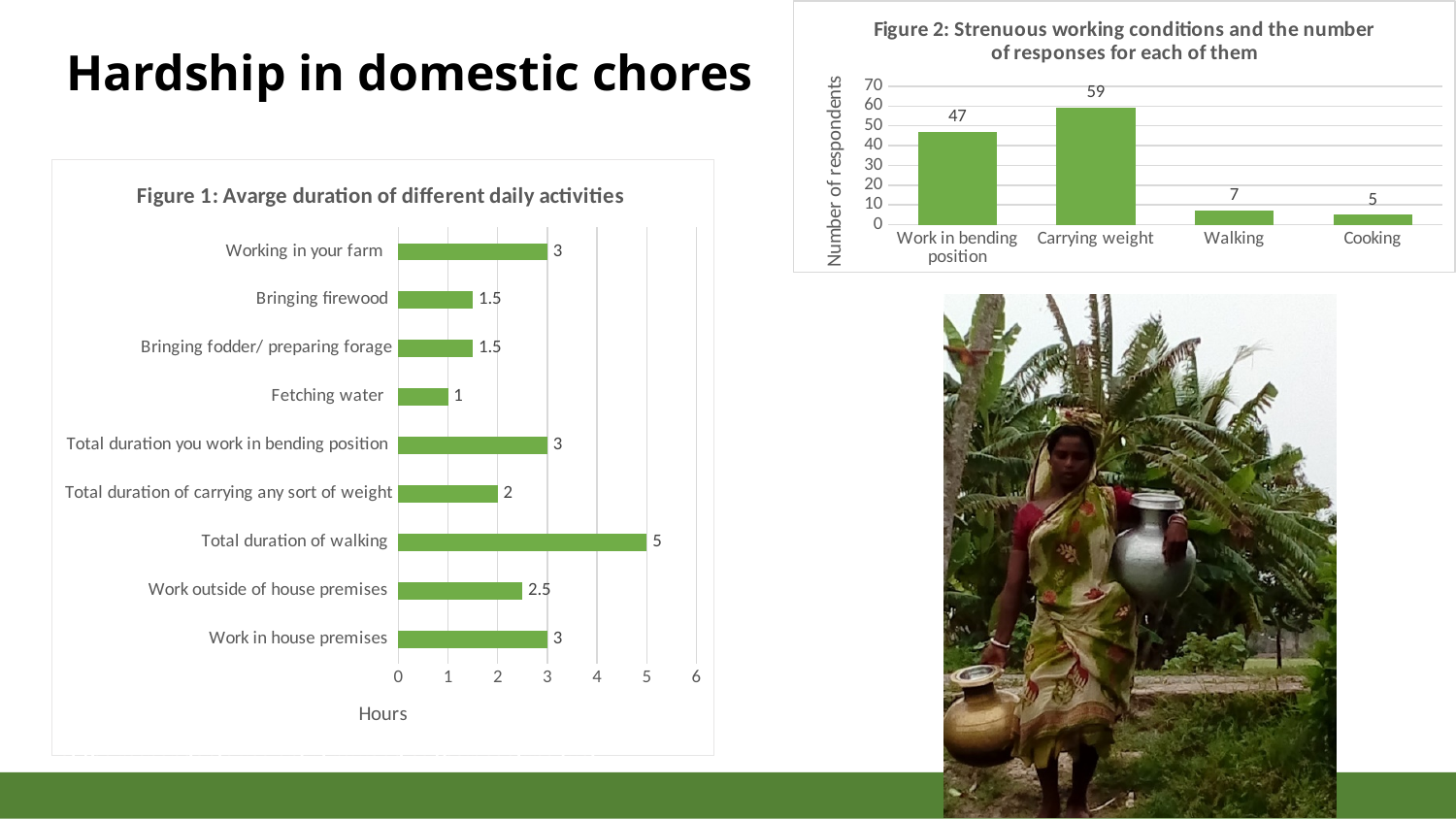
In Figure 1, what is the average duration in hours for Total duration of walking? 5 In Figure 1, which activity has the highest average duration? Total duration of walking In Figure 1, what is the difference in hours between Total duration of walking and Work outside of house premises? 2.5 In Figure 1, what is the value for Fetching water? 1 In Figure 1, which activity has the lowest average duration? Fetching water In Figure 2, what is the difference in responses between Carrying weight and Work in bending position? 12 In Figure 2, which working condition has the fewest responses? Cooking In Figure 2, what is the label of the vertical axis? Number of respondents In Figure 2, how many respondents reported Carrying weight? 59 In Figure 2, which has more responses, Walking or Cooking? Walking In Figure 1, what kind of chart is shown? Bar chart In Figure 1, how many activities are plotted? 9